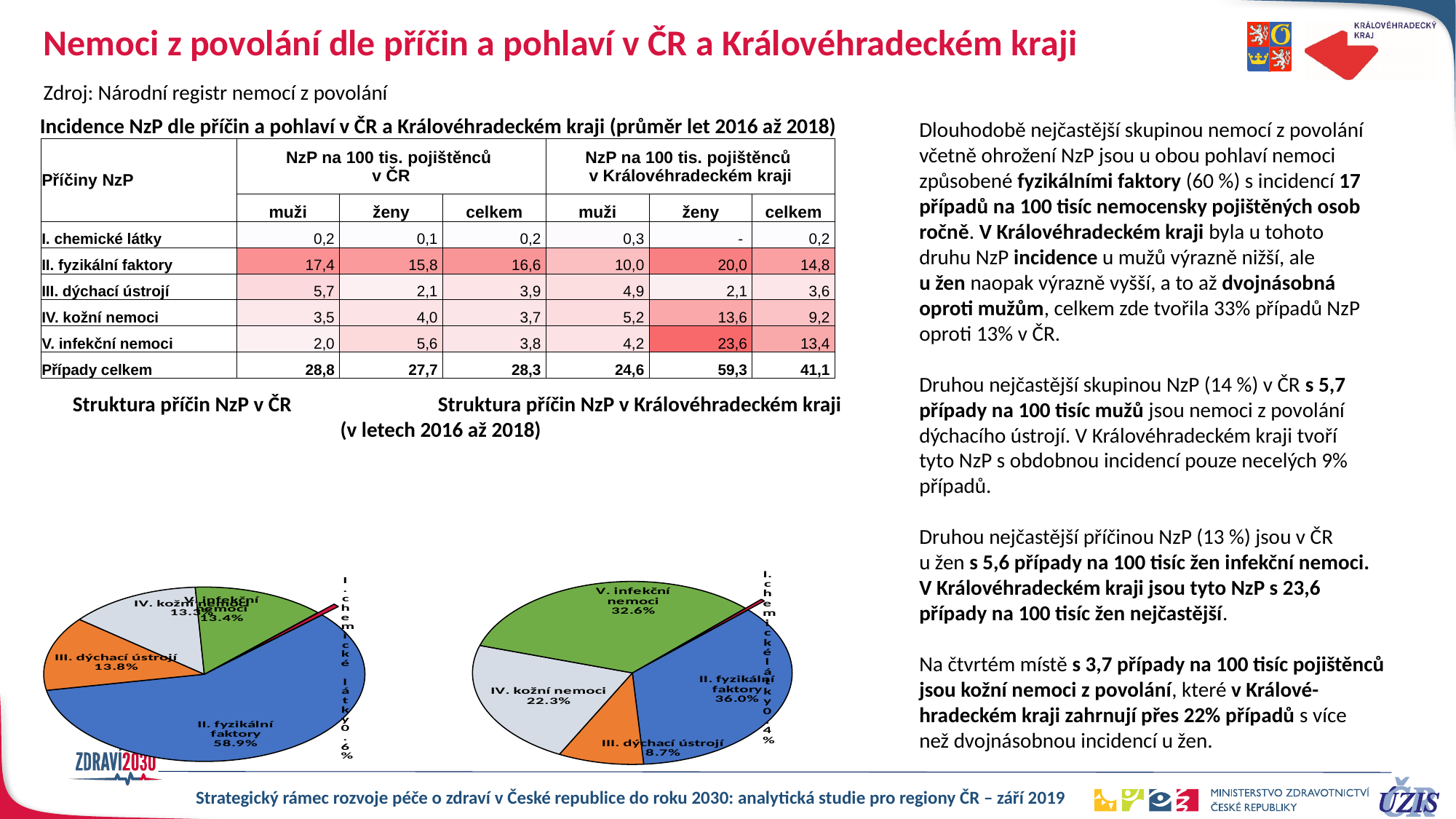
In the 'Struktura příčin NzP v ČR' pie chart, what share does 'III. dýchací ústrojí' have? 13.8% In the 'Struktura příčin NzP v Královéhradeckém kraji' pie chart, what share does 'V. infekční nemoci' have? 32.6% What kind of chart is the 'Struktura příčin NzP v ČR' chart? pie chart In the 'Struktura příčin NzP v ČR' pie chart, what share does 'II. fyzikální faktory' have? 58.9% In the 'Struktura příčin NzP v Královéhradeckém kraji' pie chart, which is larger: 'IV. kožní nemoci' or 'III. dýchací ústrojí'? IV. kožní nemoci In the 'Struktura příčin NzP v Královéhradeckém kraji' pie chart, what is the difference between the shares of 'II. fyzikální faktory' and 'V. infekční nemoci'? 3.4% In the 'Struktura příčin NzP v Královéhradeckém kraji' pie chart, which category has the largest share? II. fyzikální faktory In the 'Struktura příčin NzP v ČR' pie chart, which category has the largest share? II. fyzikální faktory In the 'Struktura příčin NzP v ČR' pie chart, which category has the smallest share? I. chemické látky How many slices does the 'Struktura příčin NzP v Královéhradeckém kraji' pie chart have? 5